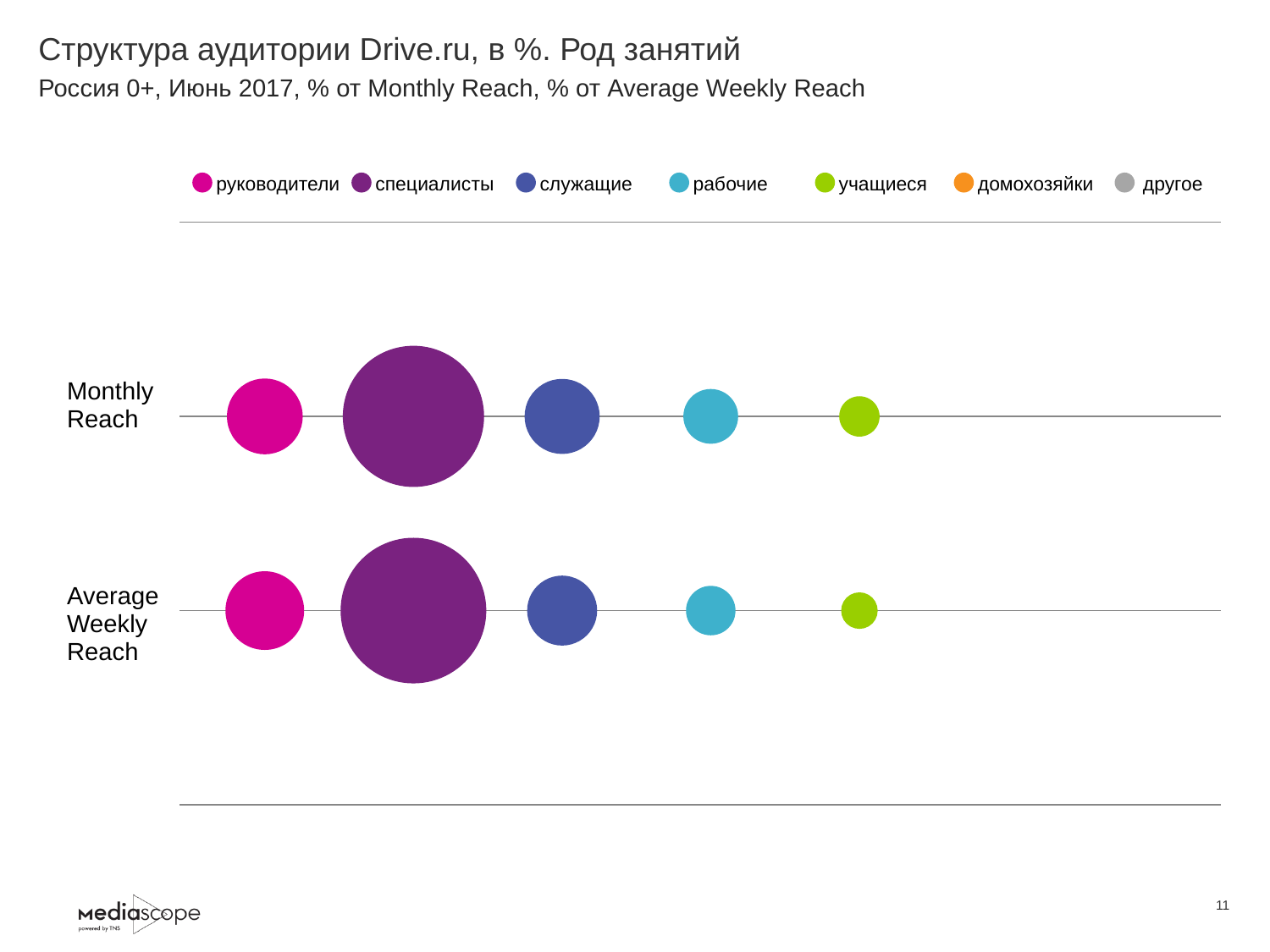
How many categories does the legend list? 7 In the Monthly Reach row, which bubble is larger: специалисты or рабочие? специалисты Among the visible bubbles in the Average Weekly Reach row, which category has the smallest? учащиеся What are the labels of the two rows plotted on the chart? Monthly Reach and Average Weekly Reach In the Average Weekly Reach row, which bubble is larger: рабочие or учащиеся? рабочие Which occupation category has the largest bubble in the Average Weekly Reach row? специалисты Which occupation category has the largest bubble in the Monthly Reach row? специалисты How many rows (reach measures) are plotted on the chart? 2 What is the title of the chart on the slide? Структура аудитории Drive.ru, в %. Род занятий Among the visible bubbles in the Monthly Reach row, which category has the smallest? учащиеся What kind of chart is shown on the slide? bubble chart